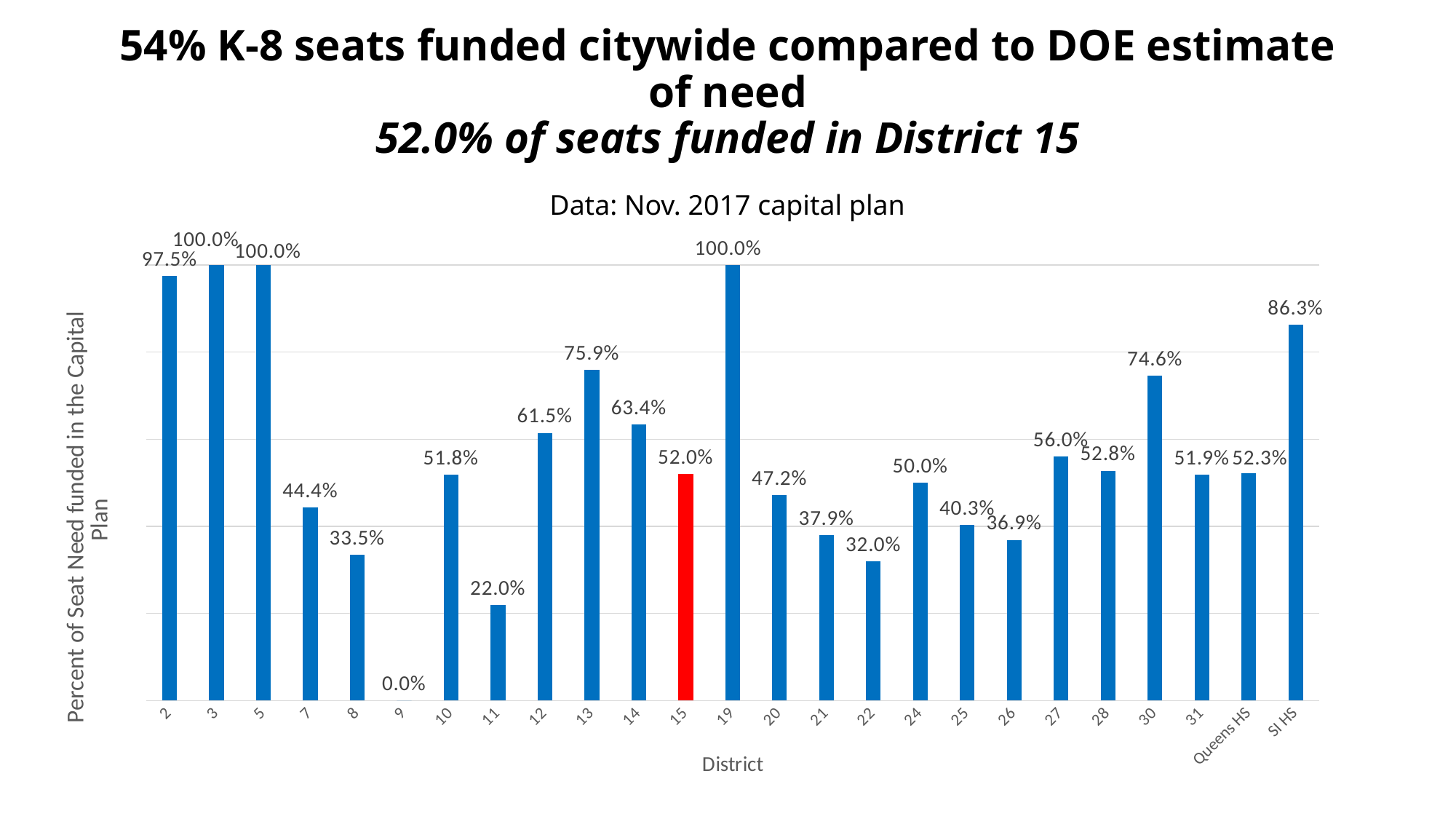
Which has a higher percent funded, District 7 or District 8? District 7 What is the value shown for District 30? 74.6% What kind of chart is shown on the slide? Bar chart Which district has the lowest percent of seat need funded? 9 What percent of seat need is funded in the capital plan for District 15? 52.0% What is the value shown for SI HS? 86.3% Which has a higher percent funded, District 12 or District 14? District 14 What is the difference between the values for District 13 and District 15? 23.9% What is the difference between the values for SI HS and Queens HS? 34.0% How many districts or categories are shown on the x axis? 25 Which district's bar is highlighted in red? 15 What percent of seat need is funded for District 11? 22.0%